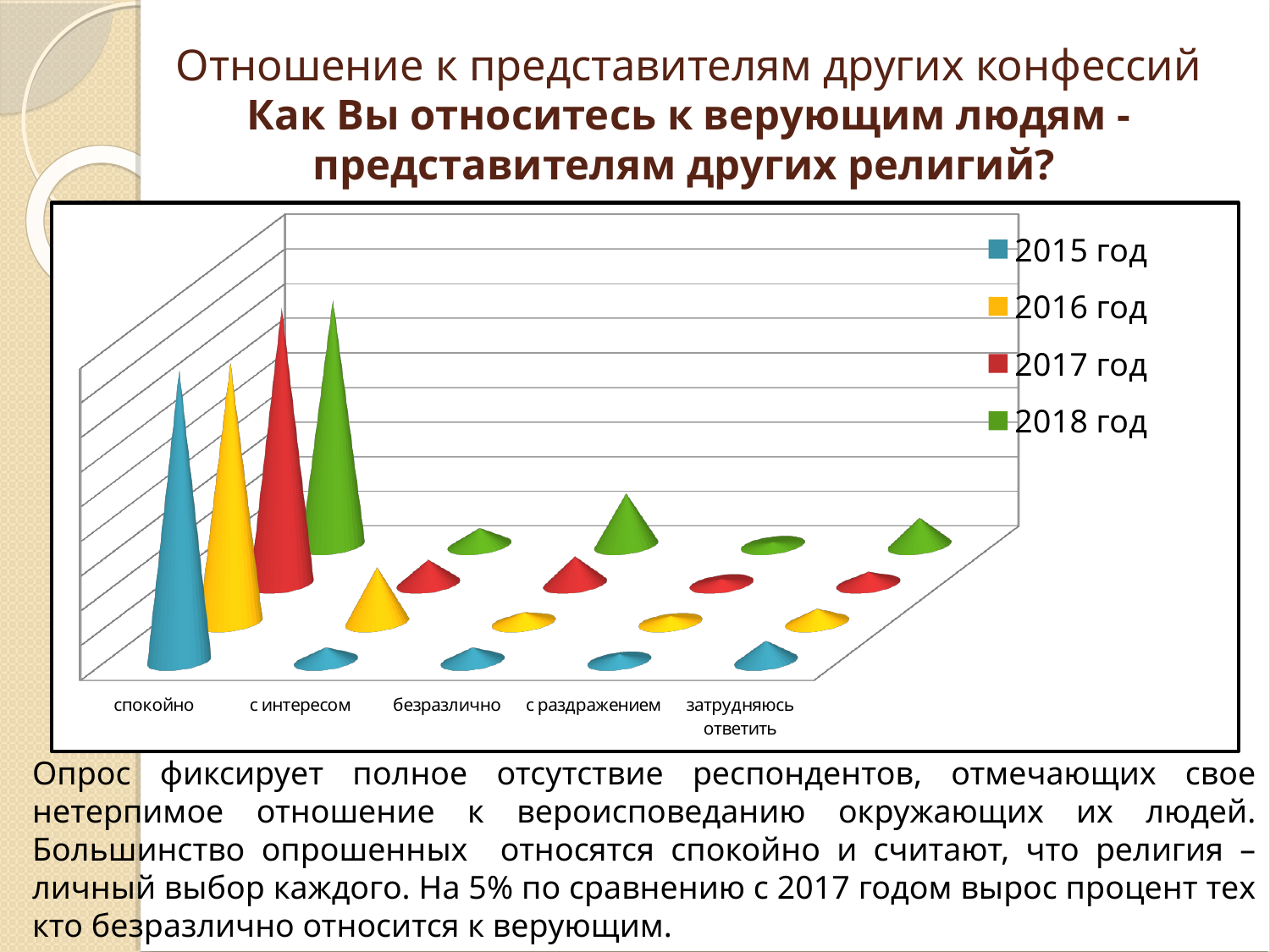
Which series is shown in green in the chart's legend? 2018 год For the 2015 год series, which is larger: the value for 'спокойно' or the value for 'затрудняюсь ответить'? спокойно What kind of chart is shown on the slide? bar chart How many series does the chart's legend list? 4 Which category has the highest value for the 2015 год series? спокойно Which series is listed first in the chart's legend? 2015 год Which category has the highest value for the 2018 год series? спокойно For the 2018 год series, which is larger: the value for 'спокойно' or the value for 'с раздражением'? спокойно How many categories are shown along the x axis of the chart? 5 For the 2016 год series, which is larger: the value for 'с интересом' or the value for 'безразлично'? с интересом Which category has the highest value for the 2016 год series? спокойно